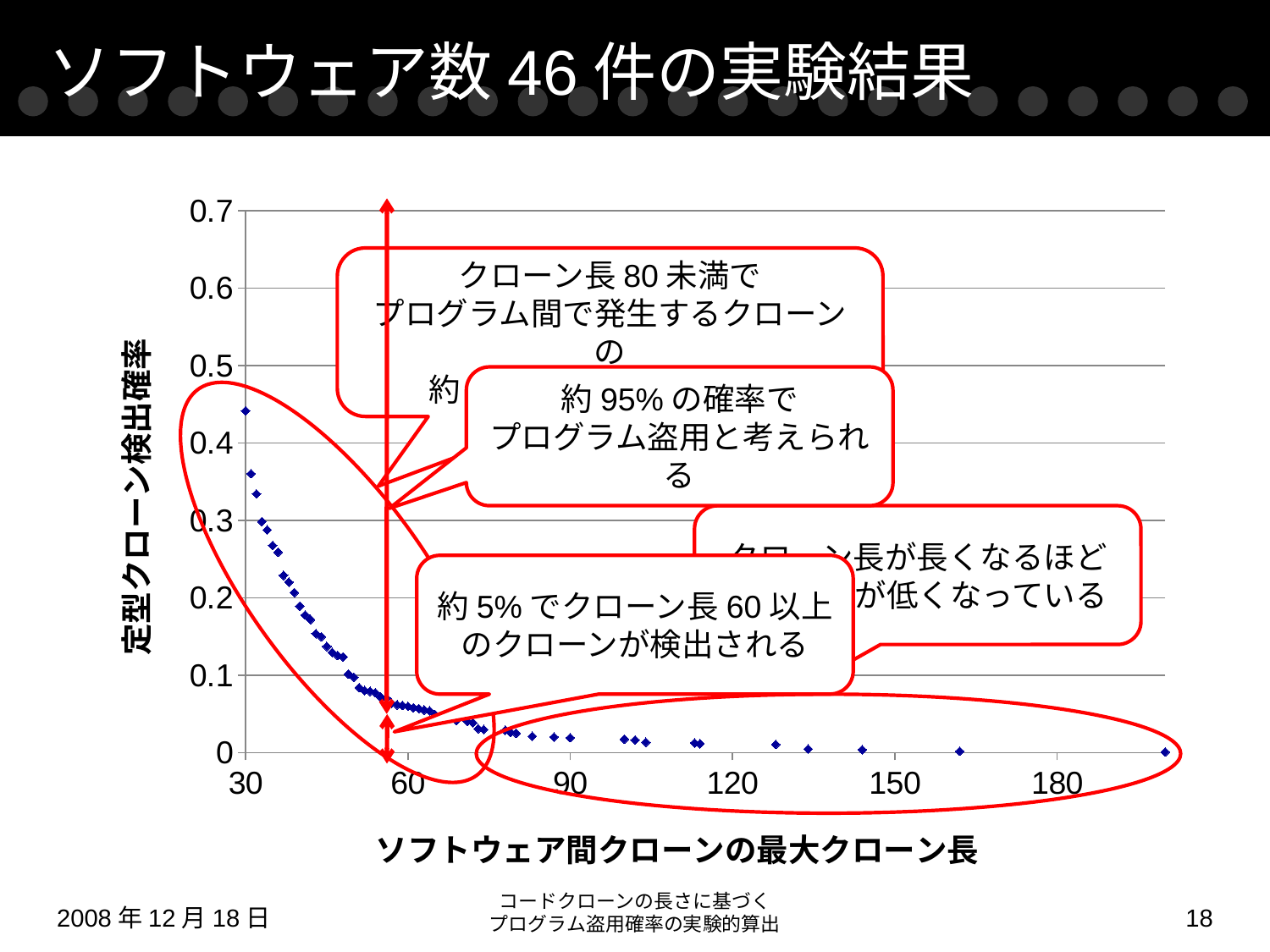
Which has the higher detection probability: the point at clone length 30 or the point at clone length 180? clone length 30 What kind of chart is shown on the slide? scatter chart Do the plotted values rise or fall as the maximum clone length on the x axis increases? fall What is the label of the y axis of the chart? 定型クローン検出確率 Is the detection probability for the points at clone length 120 greater or less than 0.1? less Is the detection probability for the points near clone length 90 greater or less than 0.1? less Is the detection probability for the point at clone length 180 greater or less than 0.1? less What is the label of the x axis of the chart? ソフトウェア間クローンの最大クローン長